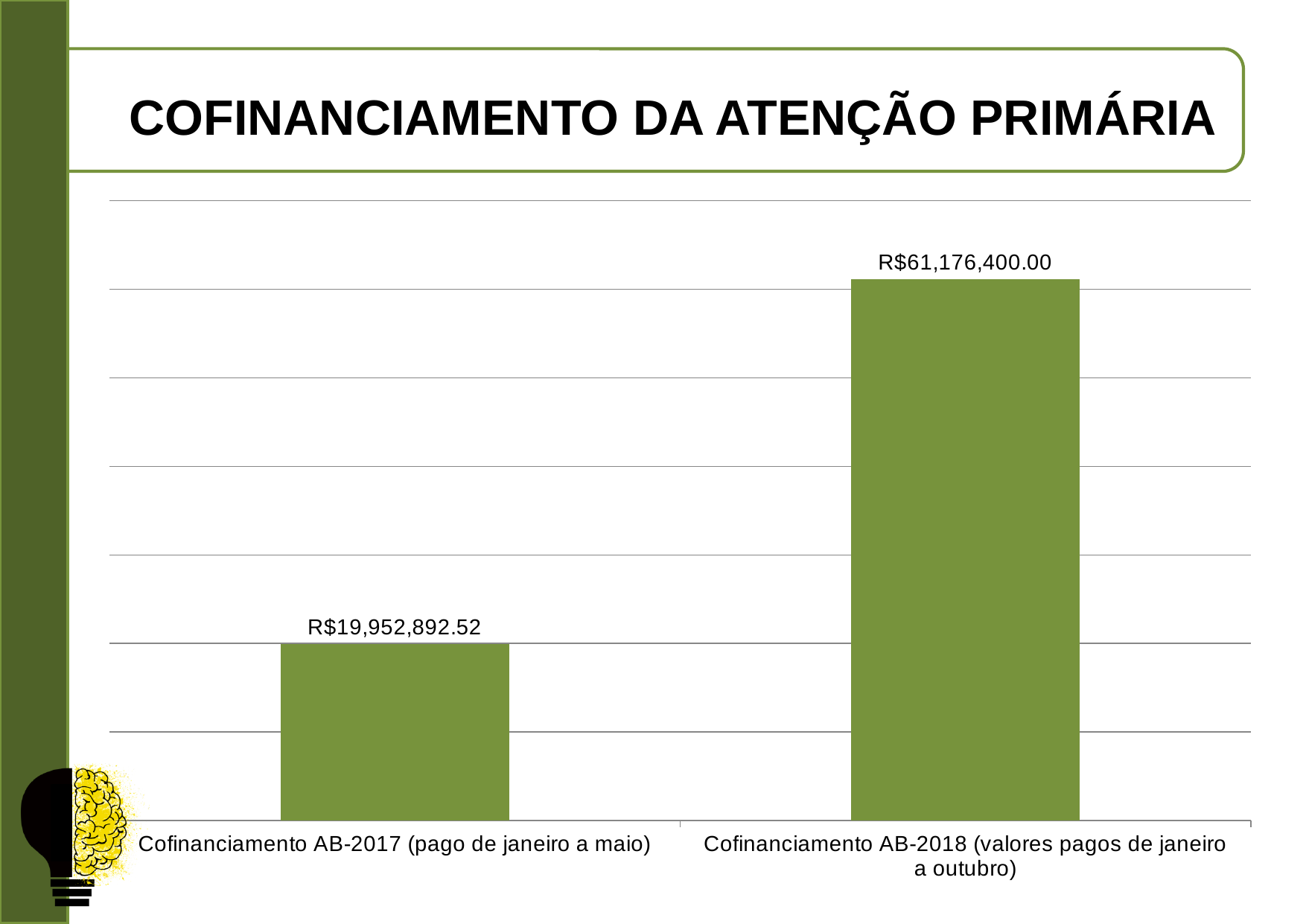
What is the value for Cofinanciamento AB-2018 (valores pagos de janeiro a outubro)? R$61,176,400.00 Which is larger, the value for Cofinanciamento AB-2017 or the value for Cofinanciamento AB-2018? Cofinanciamento AB-2018 What colour are the bars in the chart? Green Which category has the highest value? Cofinanciamento AB-2018 (valores pagos de janeiro a outubro) What kind of chart is shown on the slide? Bar chart Which category has the lowest value? Cofinanciamento AB-2017 (pago de janeiro a maio) What is the difference between the value for Cofinanciamento AB-2018 and the value for Cofinanciamento AB-2017? R$41,223,507.48 How many categories are shown in the chart? 2 What is the value for Cofinanciamento AB-2017 (pago de janeiro a maio)? R$19,952,892.52 Do the values rise or fall from the left bar to the right bar? Rise What is the title of the slide containing the chart? COFINANCIAMENTO DA ATENÇÃO PRIMÁRIA